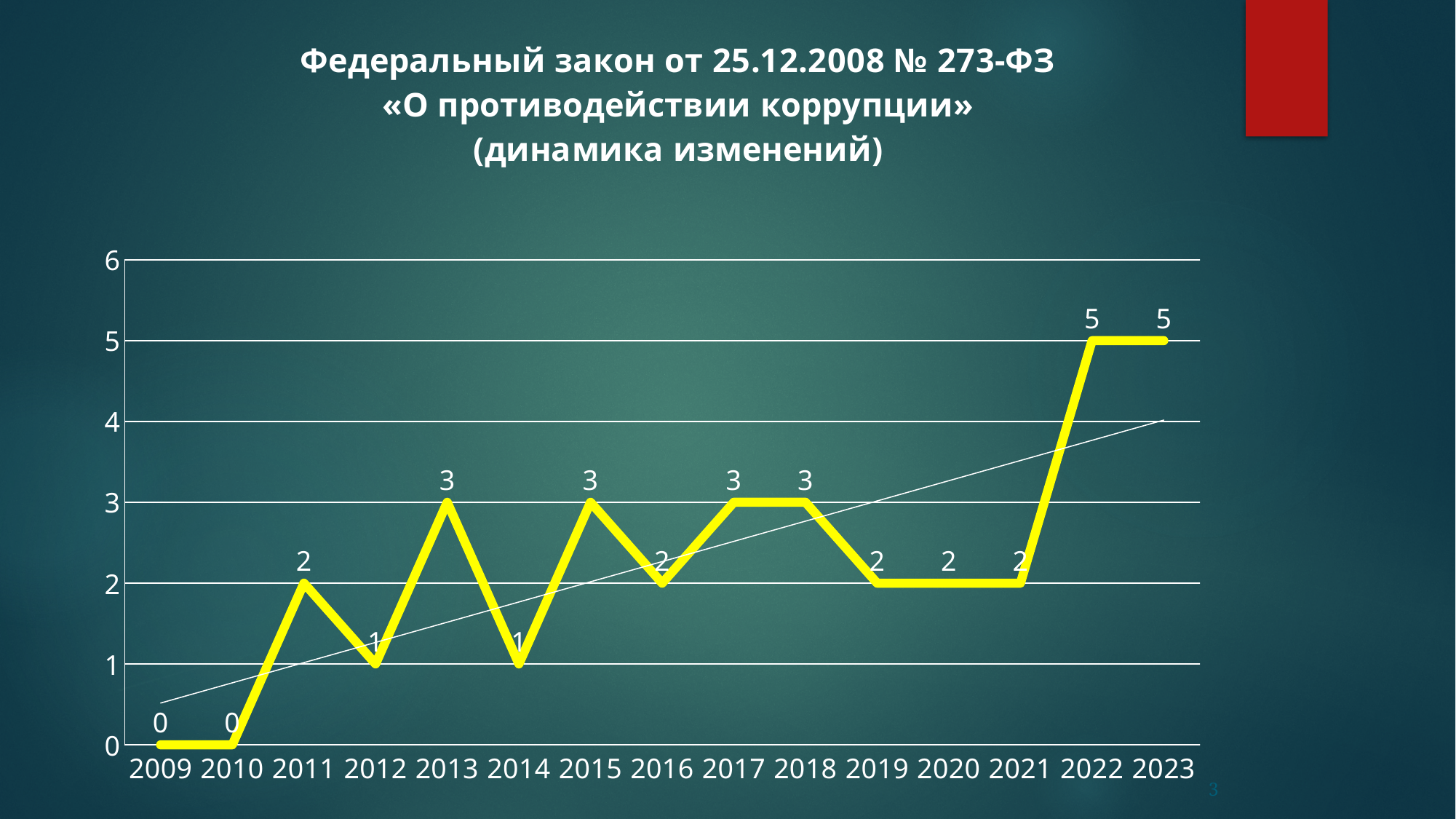
What is the value for 2016? 2 Do the values rise or fall from 2021 to 2022? rise What is the value for 2022? 5 How many years are shown on the x axis? 15 What is the highest value plotted on the chart? 5 What is the difference between the values for 2013 and 2012? 2 What is the value for 2009? 0 What is the value for 2013? 3 Which year has the larger value, 2015 or 2014? 2015 What is the value for 2011? 2 What is the difference between the values for 2022 and 2021? 3 What kind of chart is shown on the slide? line chart